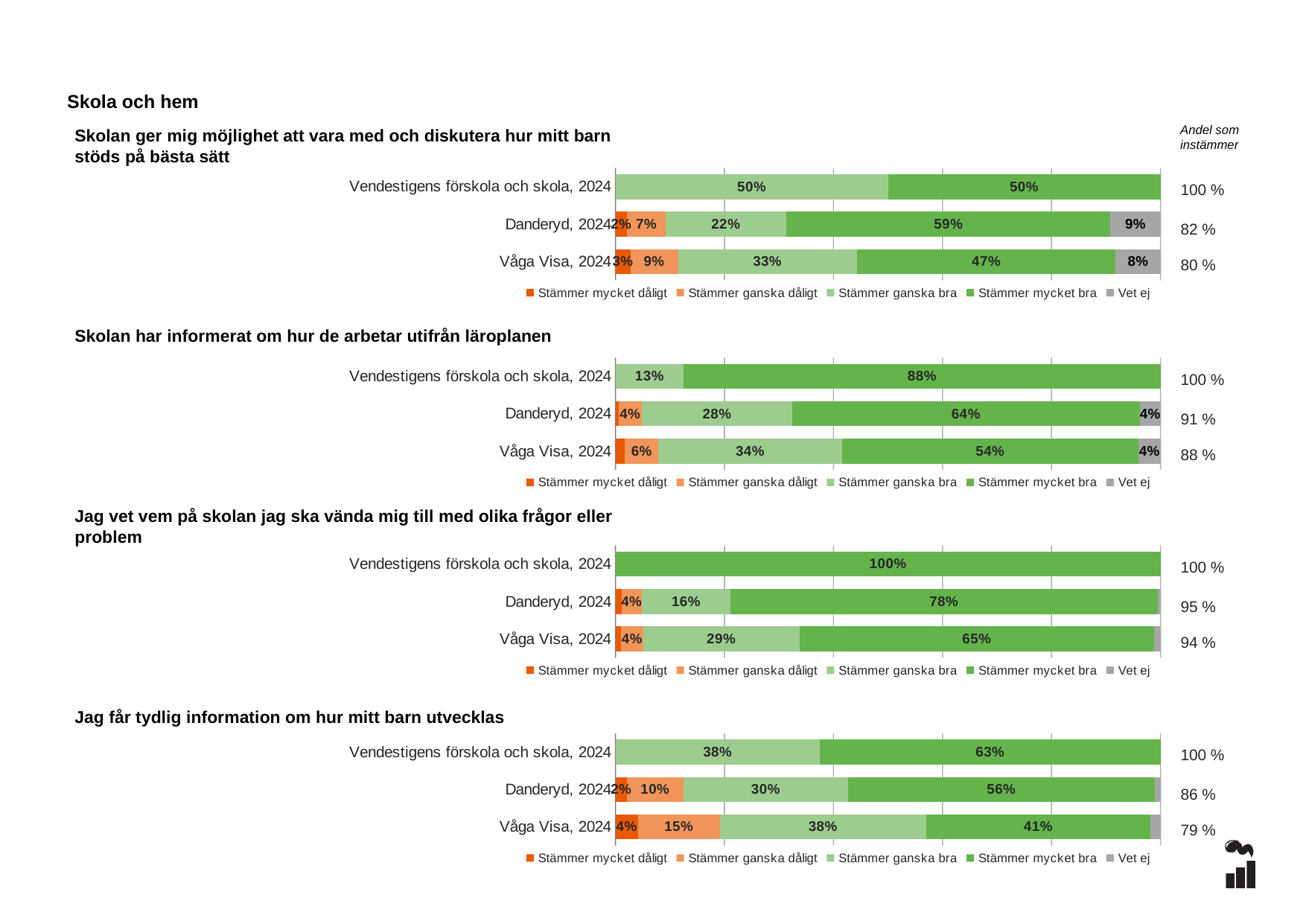
In the chart 'Skolan ger mig möjlighet att vara med och diskutera hur mitt barn stöds på bästa sätt', what is the 'Stämmer mycket bra' value for Danderyd, 2024? 59% What kind of chart is 'Skolan ger mig möjlighet att vara med och diskutera hur mitt barn stöds på bästa sätt'? Stacked bar chart How many series does the legend list for the chart 'Skolan har informerat om hur de arbetar utifrån läroplanen'? 5 In the chart 'Skolan har informerat om hur de arbetar utifrån läroplanen', what is the 'Stämmer mycket bra' value for Vendestigens förskola och skola, 2024? 88% In the chart 'Skolan ger mig möjlighet att vara med och diskutera hur mitt barn stöds på bästa sätt', what is the 'Vet ej' value for Våga Visa, 2024? 8% In the chart 'Skolan har informerat om hur de arbetar utifrån läroplanen', which row has the highest 'Stämmer ganska bra' value? Våga Visa, 2024 In the chart 'Jag vet vem på skolan jag ska vända mig till med olika frågor eller problem', what is the difference between the 'Stämmer mycket bra' values for Danderyd, 2024 and Våga Visa, 2024? 13% In the chart 'Jag får tydlig information om hur mitt barn utvecklas', what is the 'Stämmer ganska dåligt' value for Våga Visa, 2024? 15% In the chart 'Jag får tydlig information om hur mitt barn utvecklas', what is the 'Andel som instämmer' value shown for Våga Visa, 2024? 79 % How many rows (categories) are plotted in the chart 'Jag vet vem på skolan jag ska vända mig till med olika frågor eller problem'? 3 In the chart 'Jag vet vem på skolan jag ska vända mig till med olika frågor eller problem', what is the 'Stämmer mycket bra' value for Vendestigens förskola och skola, 2024? 100% In the chart 'Jag får tydlig information om hur mitt barn utvecklas', which is larger: the 'Stämmer mycket bra' value for Danderyd, 2024 or for Våga Visa, 2024? Danderyd, 2024